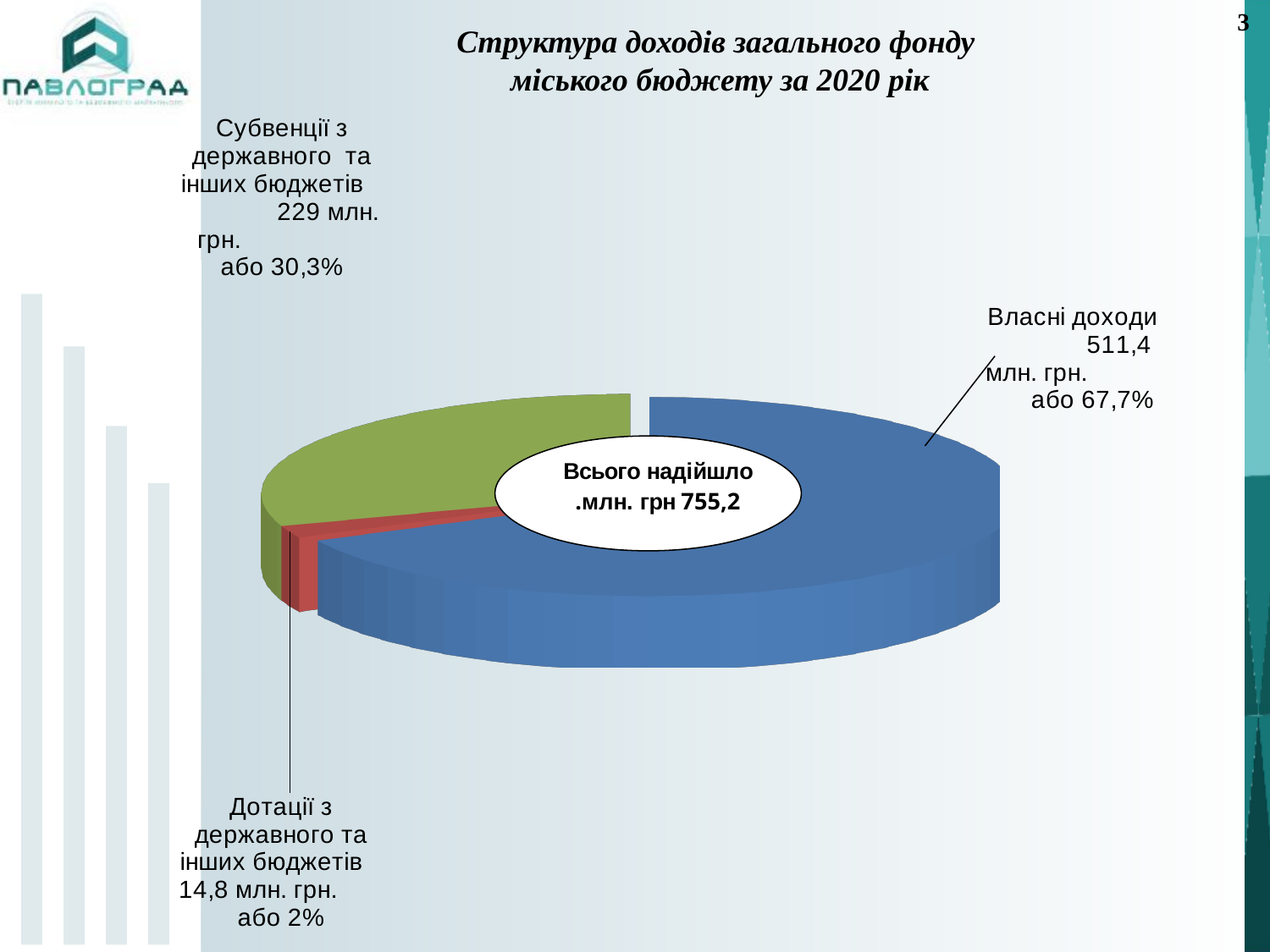
What is the value for Субвенції з державного та інших бюджетів? 229 млн. грн. What is the total amount shown in the centre of the pie chart? 755,2 млн. грн What is the value for Дотації з державного та інших бюджетів? 14,8 млн. грн. Which category has the largest slice of the pie? Власні доходи What share of the pie is Дотації з державного та інших бюджетів? 2% How many slices does the pie chart have? 3 What share of the pie is Власні доходи? 67,7% Which category has the smallest slice of the pie? Дотації з державного та інших бюджетів What kind of chart is shown on the slide? Pie chart What is the title of the chart? Структура доходів загального фонду міського бюджету за 2020 рік What is the value for Власні доходи? 511,4 млн. грн. What share of the pie is Субвенції з державного та інших бюджетів? 30,3%